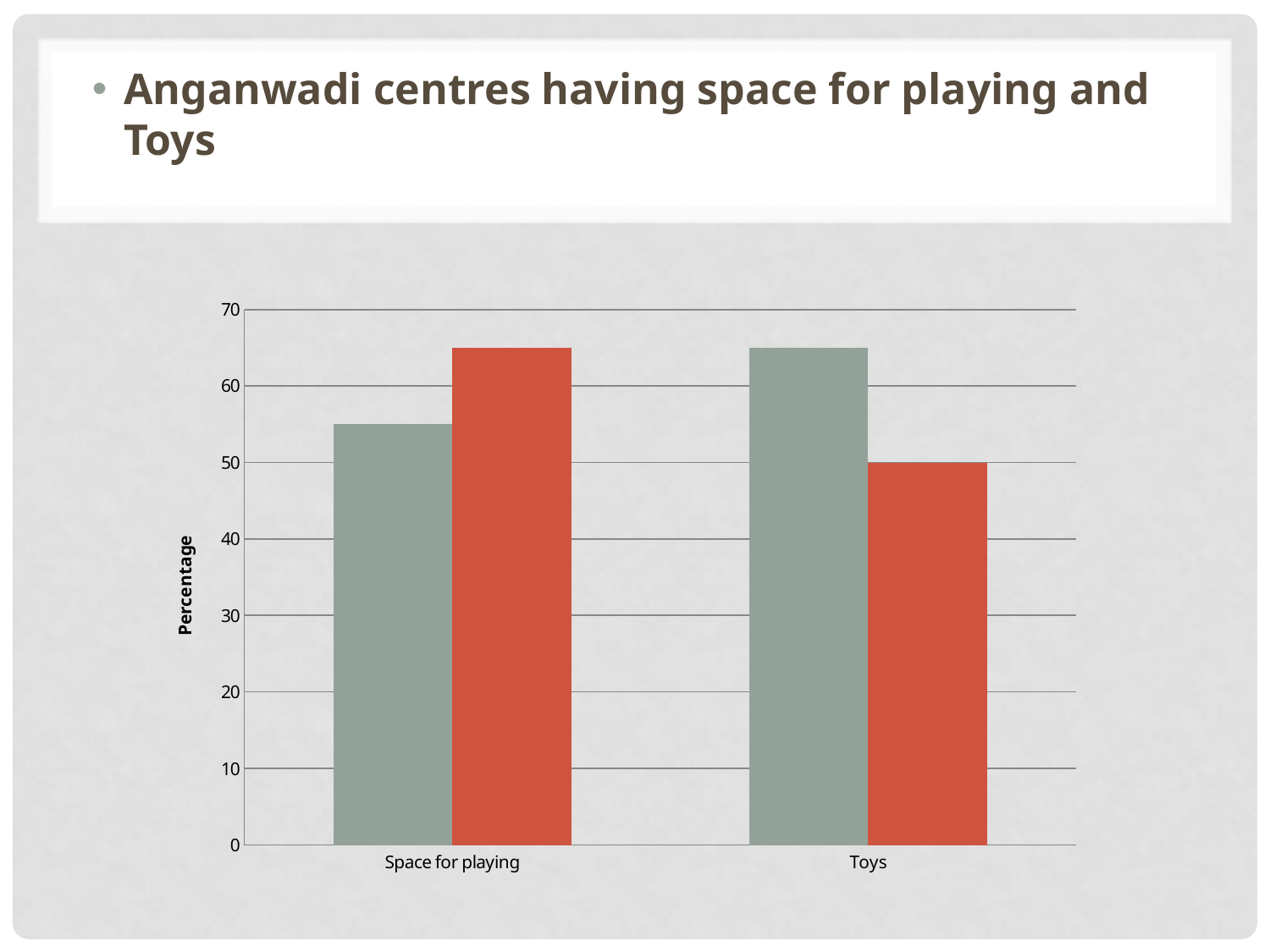
Is the value of the grey bar for Space for playing greater or less than 60? less For Space for playing, which bar is taller, the grey bar or the red bar? the red bar What is the label on the vertical axis of the chart? Percentage Which category has the lowest red bar? Toys What is the value of the red bar for Toys? 50 What kind of chart is shown on the slide? bar chart Is the value of the grey bar for Toys greater or less than 60? greater For Toys, which bar is taller, the grey bar or the red bar? the grey bar Is the value of the red bar for Space for playing greater or less than 70? less How many categories are shown on the x axis of the chart? 2